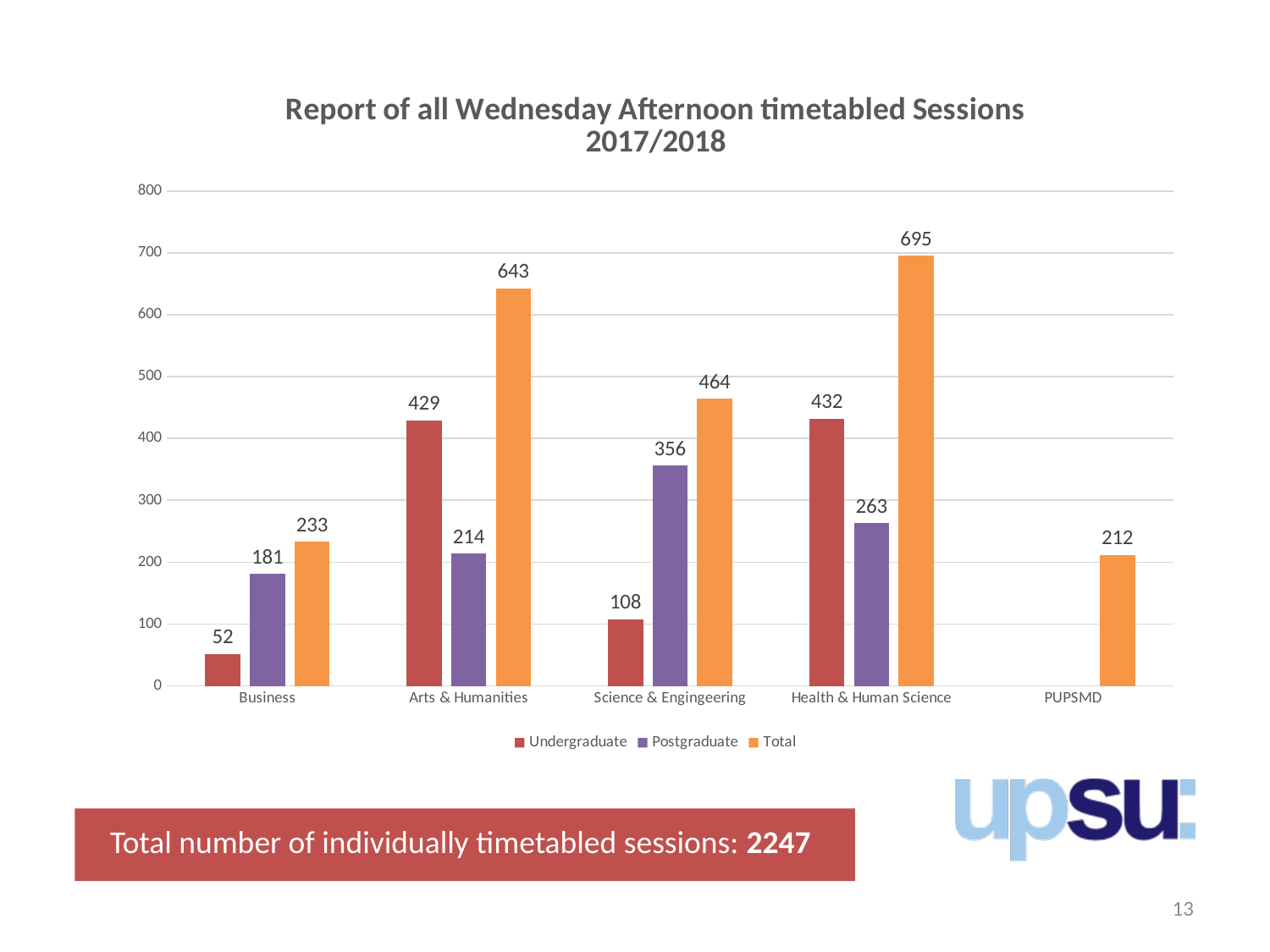
What is the Undergraduate value for Arts & Humanities? 429 What is the Postgraduate value for Science & Engineering? 356 Which category has the lowest Undergraduate value? Business Which is larger, the Postgraduate value for Health & Human Science or the Postgraduate value for Arts & Humanities? Health & Human Science Which category has the highest Total value? Health & Human Science Is the Total value for Science & Engineering greater or less than 400? greater What kind of chart is shown on the slide? bar chart What is the difference between the Total values for Arts & Humanities and Business? 410 What is the Total value for PUPSMD? 212 What is the title of the chart? Report of all Wednesday Afternoon timetabled Sessions 2017/2018 How many series does the legend list? 3 How many categories are shown on the x axis? 5